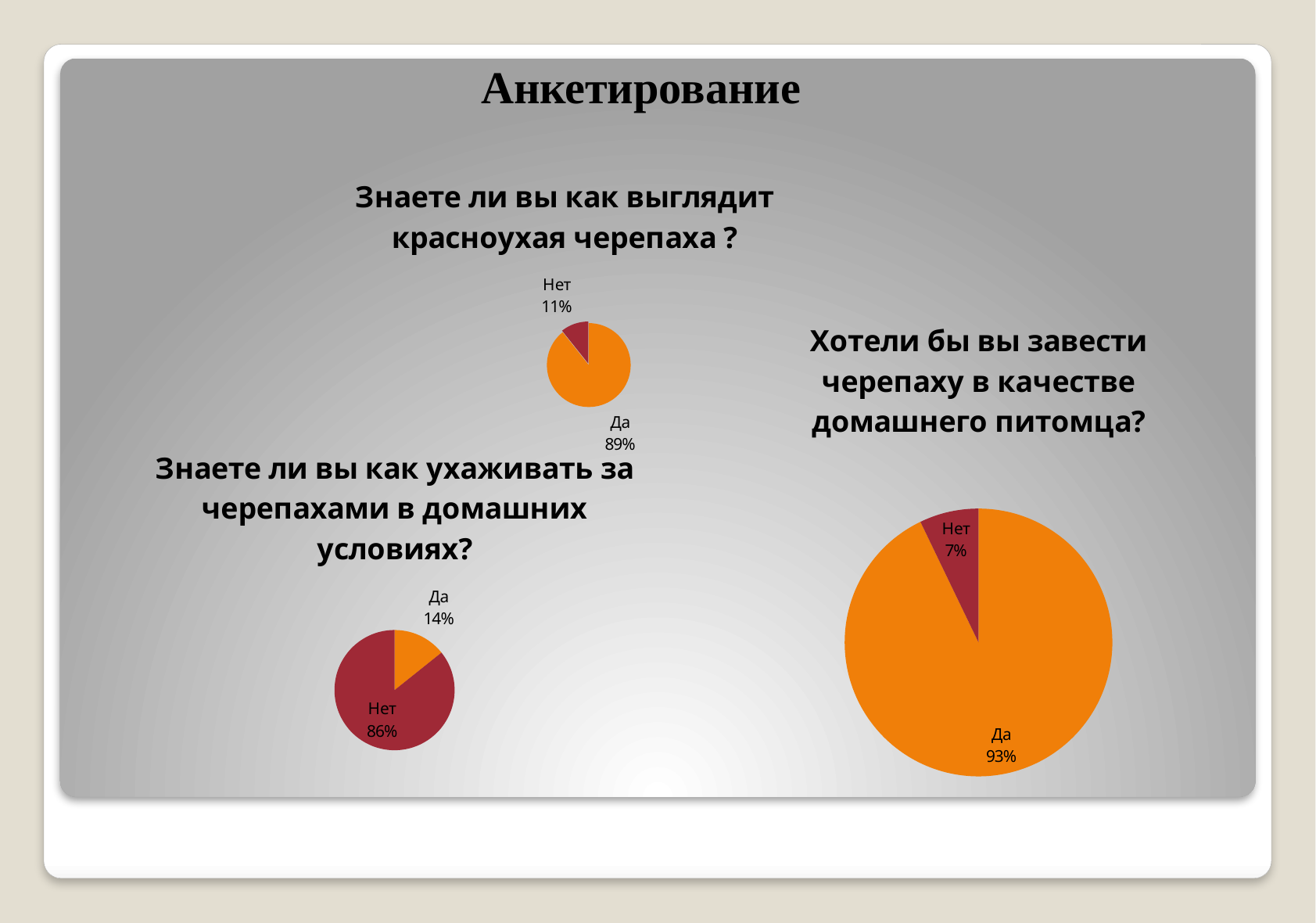
In the pie chart titled "Знаете ли вы как ухаживать за черепахами в домашних условиях?", which answer has the largest slice? Нет In the pie chart titled "Хотели бы вы завести черепаху в качестве домашнего питомца?", which answer has the smallest slice? Нет In the pie chart titled "Знаете ли вы как ухаживать за черепахами в домашних условиях?", what share of respondents answered "Нет"? 86% In the pie chart titled "Хотели бы вы завести черепаху в качестве домашнего питомца?", what share of respondents answered "Нет"? 7% What type of chart is used for the question "Знаете ли вы как ухаживать за черепахами в домашних условиях?"? Pie chart In the pie chart titled "Хотели бы вы завести черепаху в качестве домашнего питомца?", what share of respondents answered "Да"? 93% In the pie chart titled "Знаете ли вы как выглядит красноухая черепаха ?", what is the difference between the "Да" and "Нет" shares? 78% How many charts are shown on the slide? 3 In the pie chart titled "Знаете ли вы как ухаживать за черепахами в домашних условиях?", what share of respondents answered "Да"? 14% In the pie chart titled "Знаете ли вы как выглядит красноухая черепаха ?", what share of respondents answered "Да"? 89% In the pie chart titled "Хотели бы вы завести черепаху в качестве домашнего питомца?", which is larger, "Да" or "Нет"? Да In the pie chart titled "Знаете ли вы как выглядит красноухая черепаха ?", what share of respondents answered "Нет"? 11%